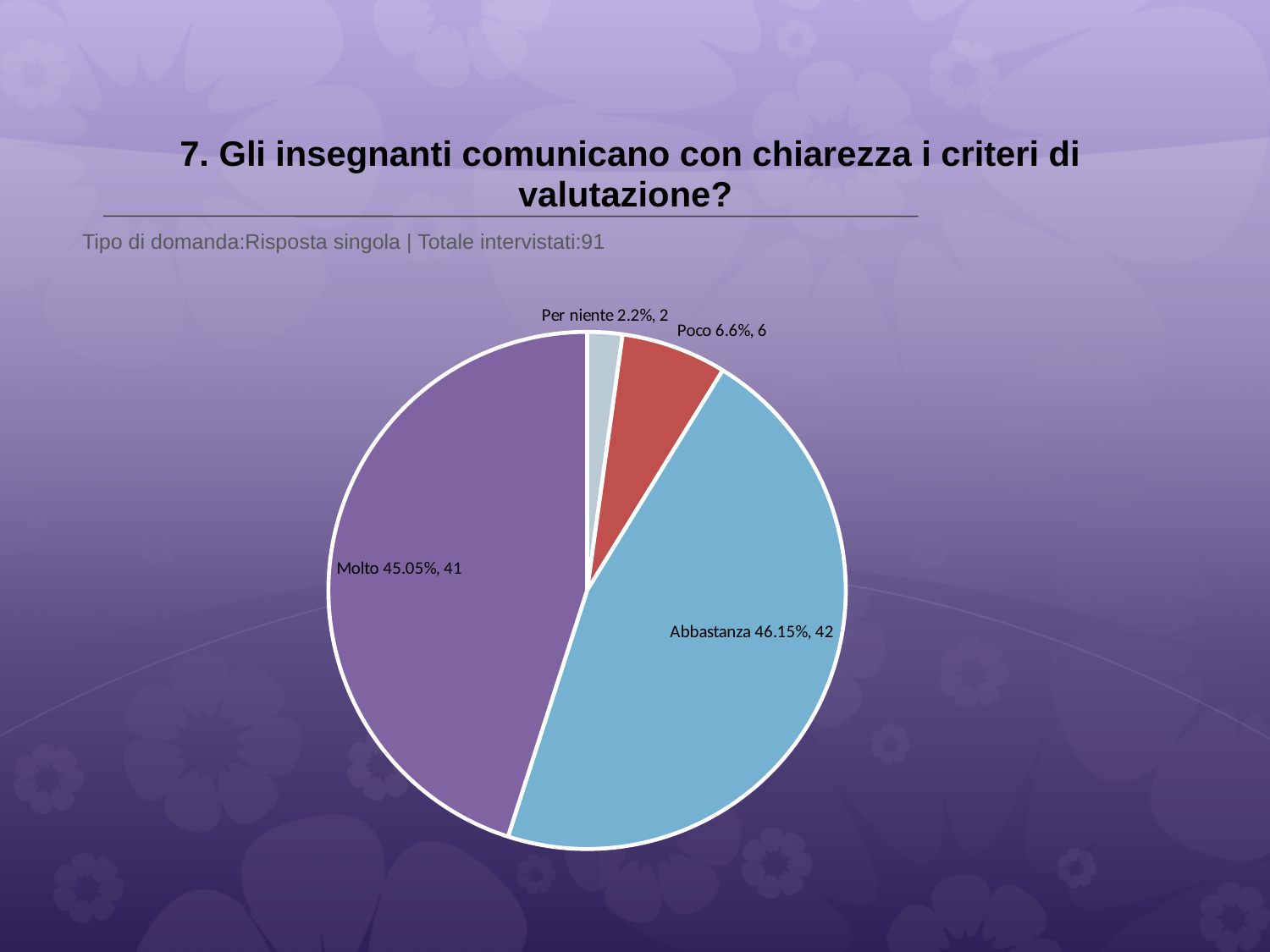
According to the data labels, which category has the largest slice of the pie? Abbastanza How many respondents answered 'Poco'? 6 What is the difference in number of respondents between 'Abbastanza' and 'Molto'? 1 What is the total number of respondents (Totale intervistati) stated on the slide? 91 How many respondents answered 'Per niente'? 2 What percentage is shown for the 'Poco' slice? 6.6% How many slices does the pie chart have? 4 What percentage of the pie does the 'Molto' slice represent? 45.05% Which has more respondents, 'Poco' or 'Per niente'? Poco What percentage of the pie does the 'Abbastanza' slice represent? 46.15% Which category has the smallest slice of the pie? Per niente What kind of chart is shown on the slide? pie chart